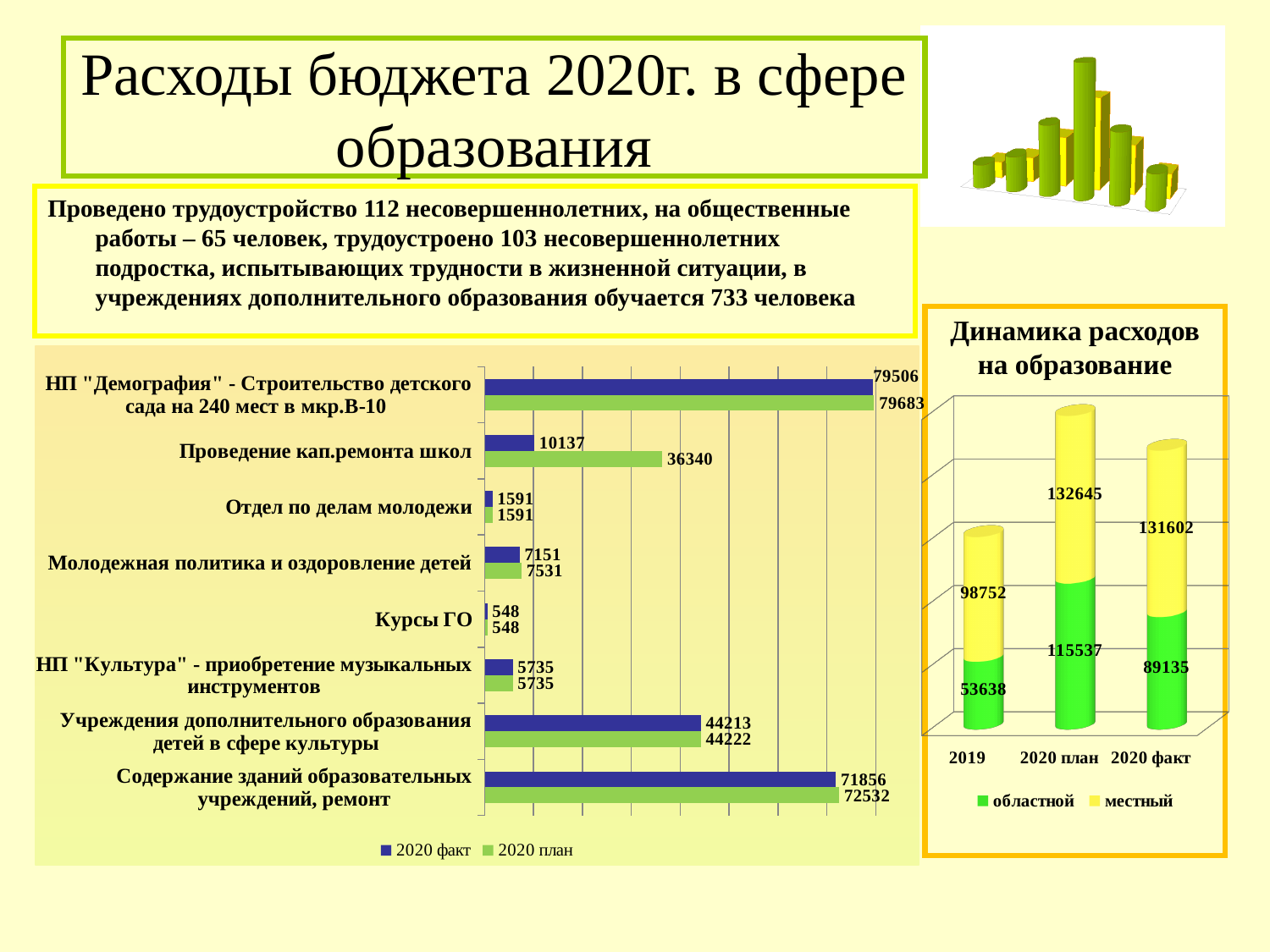
In the left bar chart, what is the 2020 факт value for Проведение кап.ремонта школ? 10137 What kind of chart is the left chart? Bar chart In the chart titled Динамика расходов на образование, what is the местный value for 2020 план? 132645 In the left bar chart, which category has the lowest 2020 факт value? Курсы ГО In the left bar chart, which category has the highest 2020 план value? НП "Демография" - Строительство детского сада на 240 мест в мкр.В-10 In the chart titled Динамика расходов на образование, what is the total of the stacked bar for 2019? 152390 In the left bar chart, how many series does the legend list? 2 In the left bar chart, what is the 2020 план value for Содержание зданий образовательных учреждений, ремонт? 72532 In the chart titled Динамика расходов на образование, what are the two legend entries? областной, местный In the chart titled Динамика расходов на образование, which is larger: the областной value for 2020 план or for 2020 факт? 2020 план In the left bar chart, how many categories are shown? 8 In the left bar chart, what is the difference between the 2020 план and 2020 факт values for Проведение кап.ремонта школ? 26203